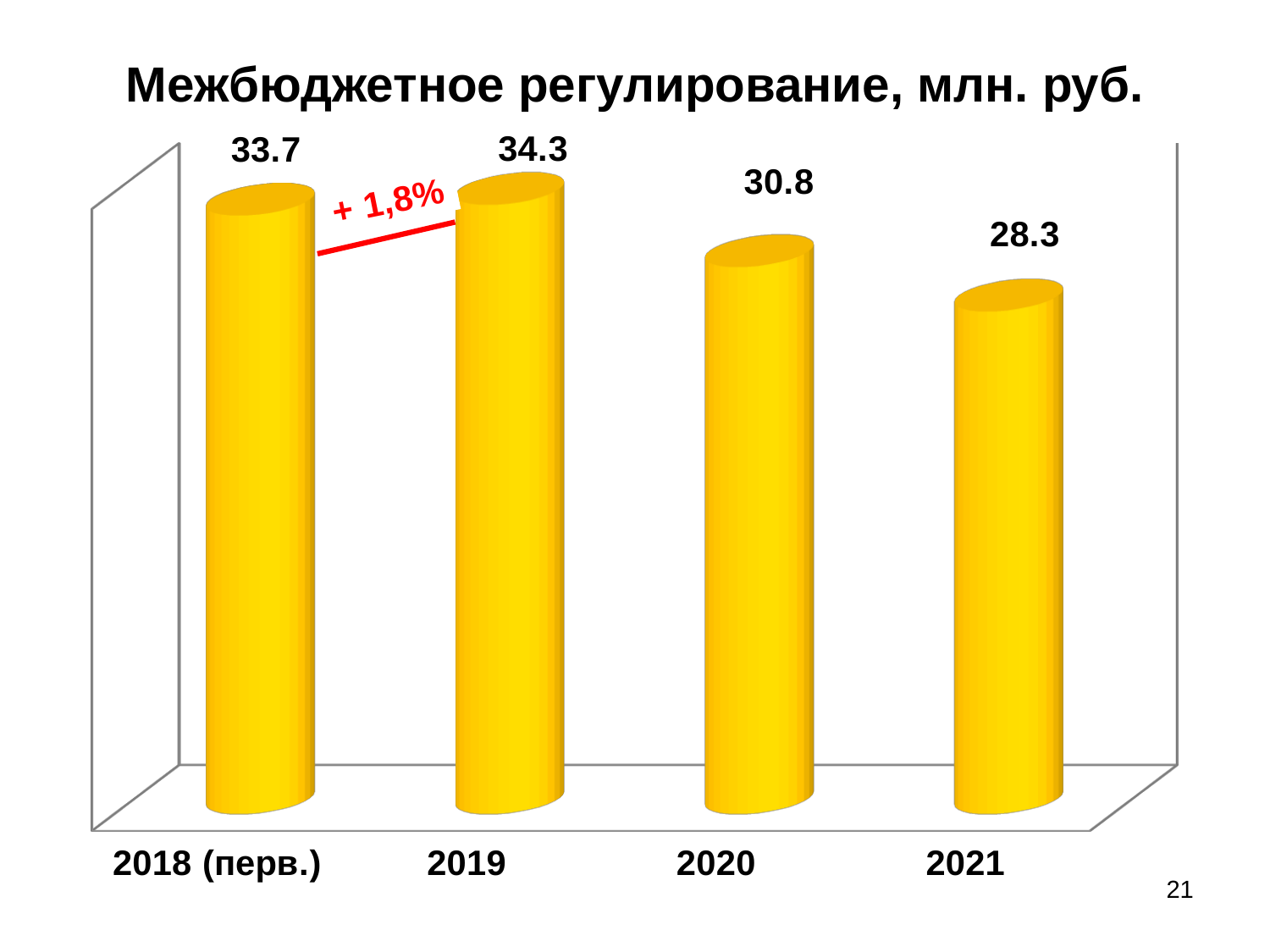
What is the difference between the values for 2019 and 2021? 6.0 What is the value for 2019? 34.3 What is the difference between the values for 2018 (перв.) and 2020? 2.9 What is the value for 2020? 30.8 What kind of chart is shown on the slide? bar chart What is the value for 2018 (перв.)? 33.7 What is the value for 2021? 28.3 Which category has the highest value? 2019 Which is larger, the value for 2020 or the value for 2021? 2020 What percentage change is annotated between 2018 (перв.) and 2019? + 1,8% Which category has the lowest value? 2021 How many categories are shown on the chart? 4